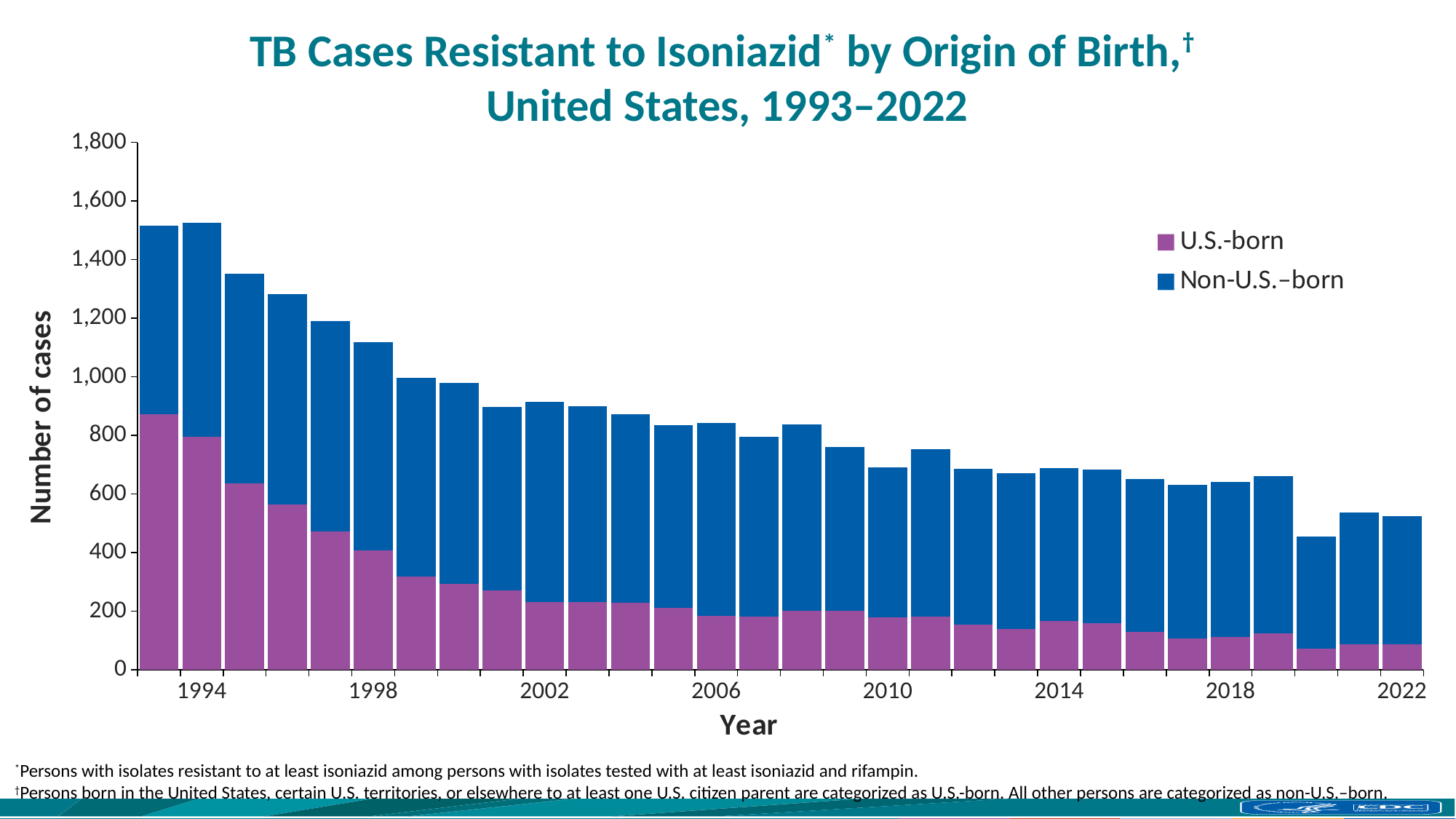
How many series does the legend list? 2 Which year has the lowest total number of cases? 2020 Does the total number of cases generally rise or fall from 1993 to 2022? Fall Is the number of U.S.-born cases in 2022 greater or less than 200? less What are the two series named in the legend? U.S.-born and Non-U.S.–born What kind of chart is shown on the slide? Stacked bar chart Which year has the larger total number of cases, 1993 or 2022? 1993 Is the total number of cases for 1994 greater or less than 1,400? greater How many years (bars) are plotted in the chart? 30 Is the number of U.S.-born cases in 1994 greater or less than 600? greater What is the label of the y-axis? Number of cases